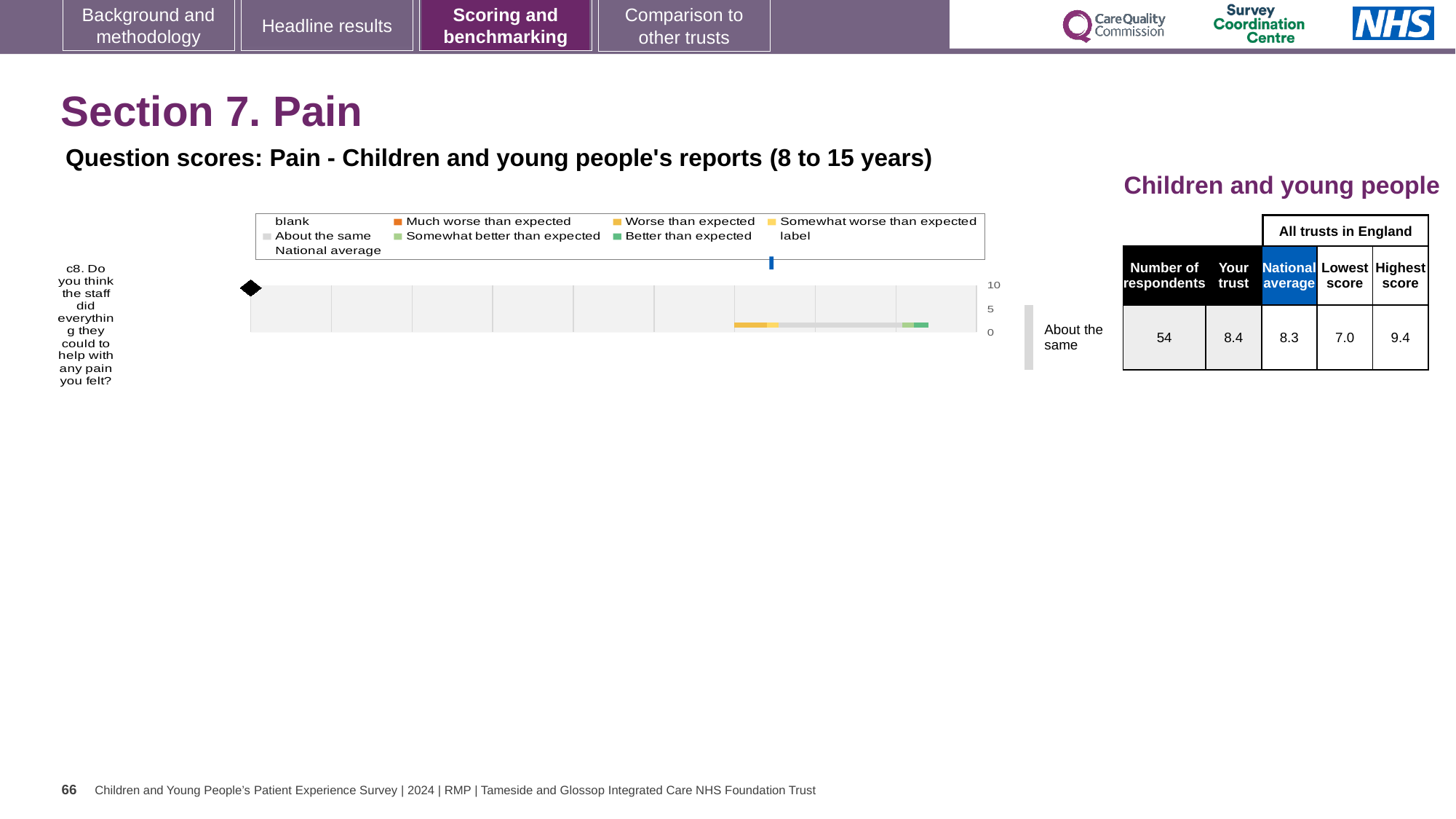
How many respondents answered question c8? 54 What is the highest score among all trusts in England for question c8? 9.4 What is the highest value shown on the chart's score axis? 10 What kind of chart is shown on the slide? bar chart What is the 'Your trust' score for question c8? 8.4 How many survey questions are plotted in the chart? 1 Which question is plotted in the chart? c8. Do you think the staff did everything they could to help with any pain you felt? How is the trust's result for question c8 categorised relative to other trusts? About the same Is the trust's score for question c8 higher or lower than the national average? higher What is the difference between the highest and lowest scores among all trusts in England for question c8? 2.4 What is the lowest score among all trusts in England for question c8? 7.0 What is the national average score for question c8? 8.3